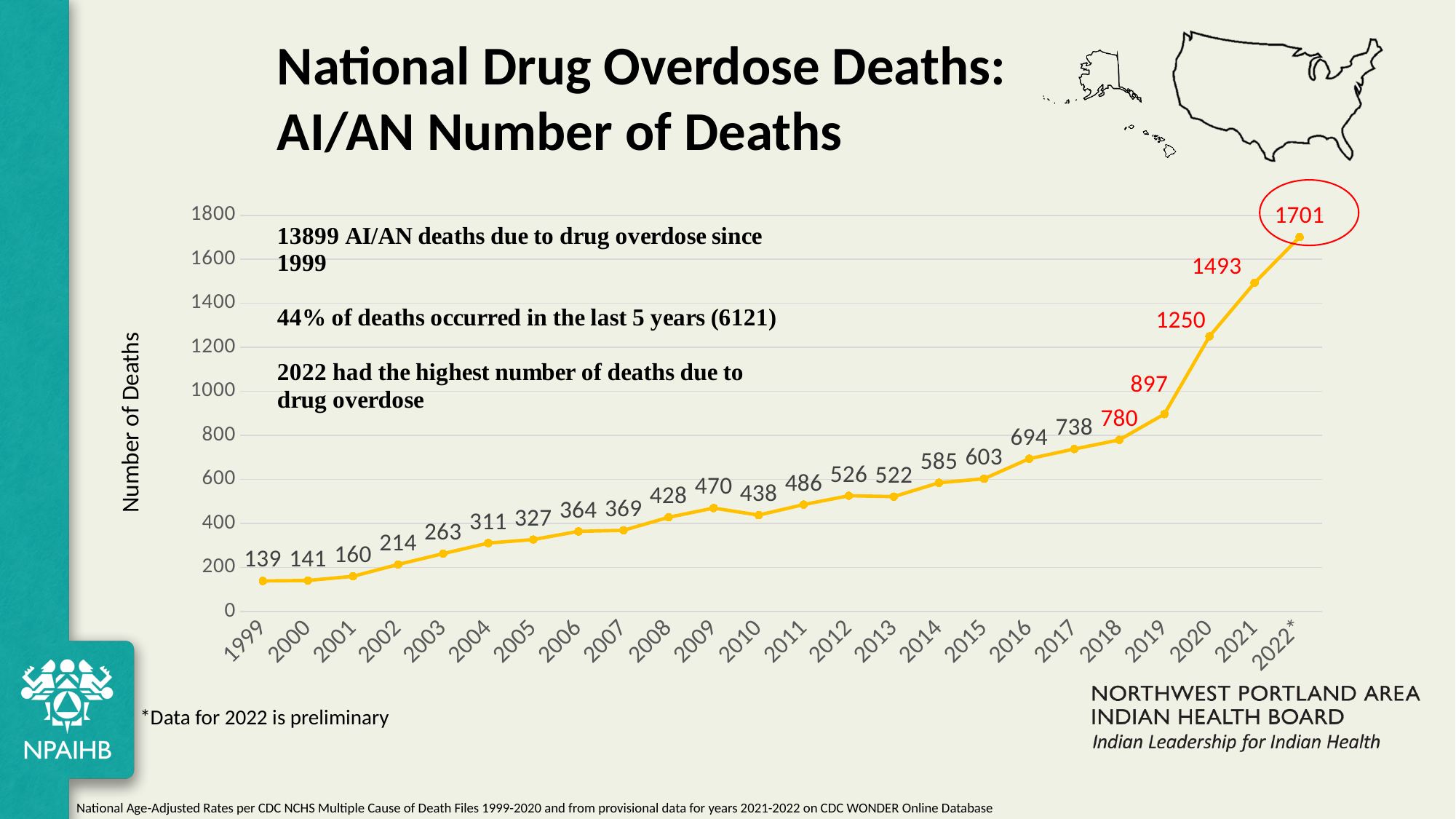
What is the difference in deaths between 2022* and 2021? 208 What is the label of the y axis? Number of Deaths What is the number of AI/AN drug overdose deaths in 1999? 139 What type of chart is shown on the slide? Line chart Which year had more deaths, 2009 or 2010? 2009 Which year has the lowest number of deaths? 1999 What is the number of AI/AN drug overdose deaths in 2019? 897 Which year has the highest number of deaths? 2022* What is the overall trend in the number of deaths from 1999 to 2022*? Rising What is the difference in deaths between 2013 and 2012? 4 How many years are plotted on the x axis? 24 What is the number of AI/AN drug overdose deaths in 2010? 438